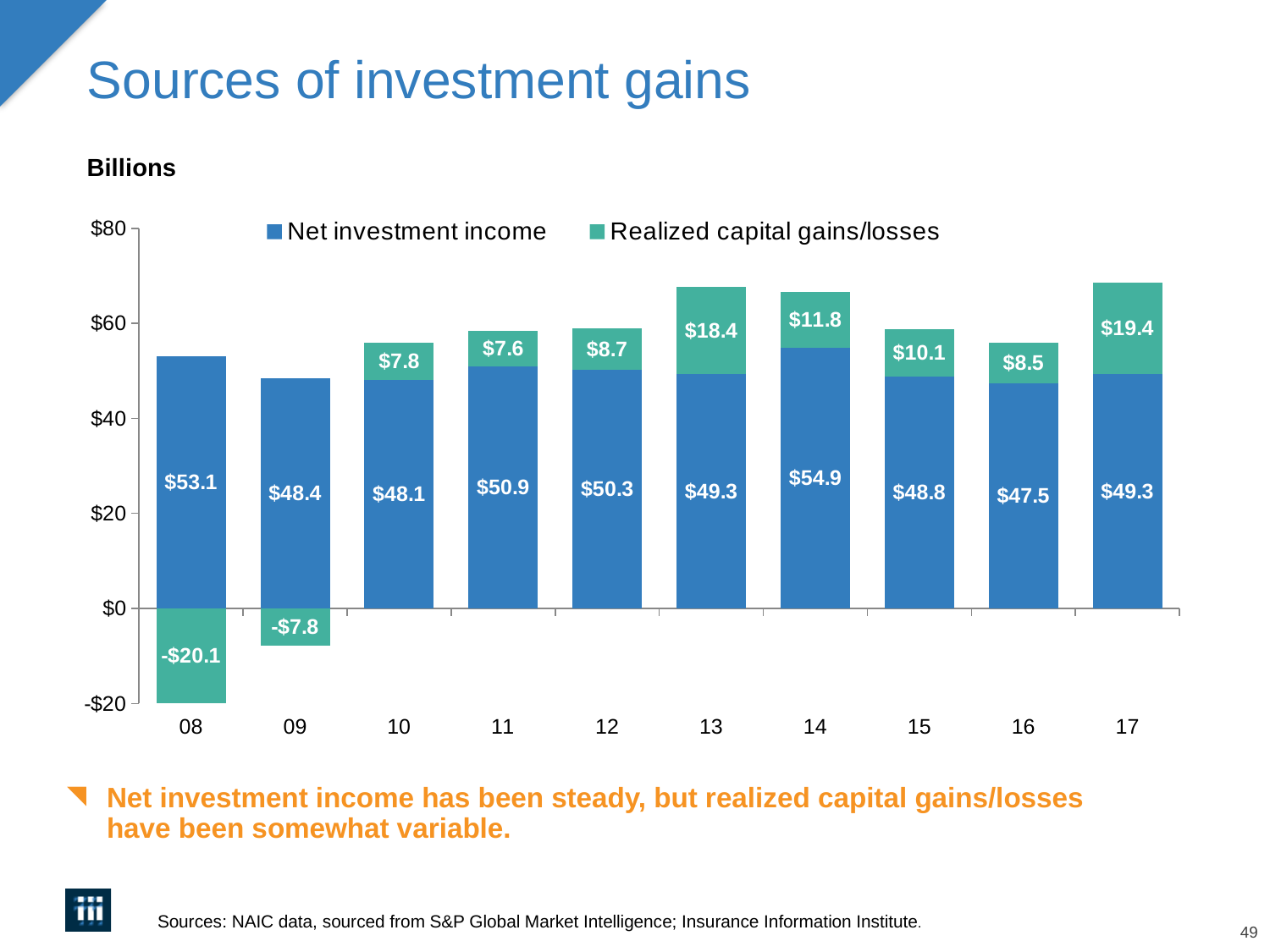
What were realized capital gains/losses in 17? $19.4 In which year was net investment income lowest? 16 What is the total of net investment income and realized capital gains/losses for 17? $68.7 In which year was net investment income highest? 14 What is the difference between net investment income in 14 and in 16? $7.4 How many years are shown on the x axis? 10 What were realized capital gains/losses in 08? -$20.1 What kind of chart is shown on the slide? Stacked bar chart In which year were realized capital gains/losses lowest? 08 Which year had larger realized capital gains/losses, 13 or 14? 13 How many series does the legend list? 2 What was net investment income in 14? $54.9